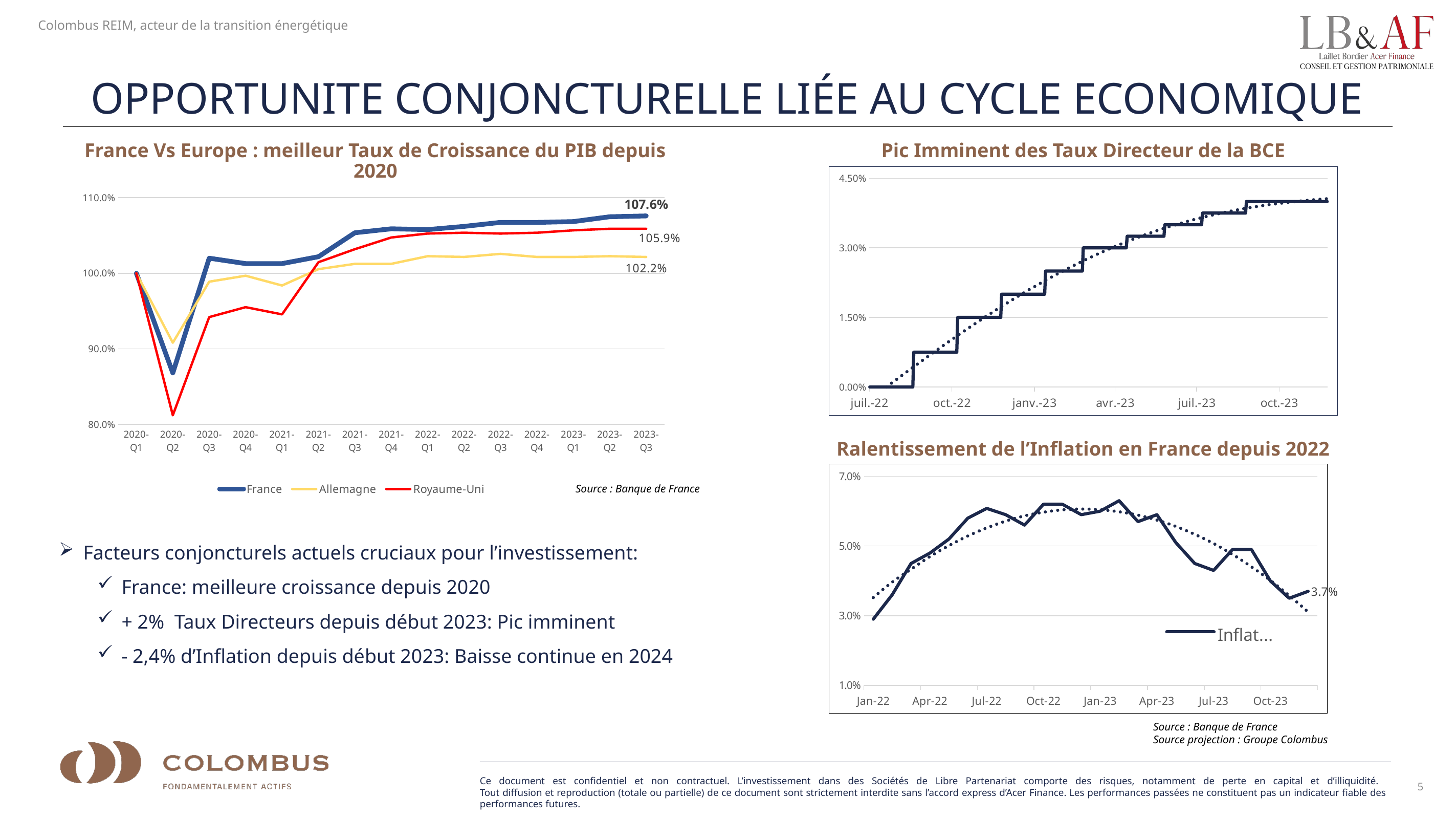
In the chart 'France Vs Europe : meilleur Taux de Croissance du PIB depuis 2020', which is larger at 2023-Q3: Royaume-Uni or Allemagne? Royaume-Uni How many quarters are shown on the x axis of the chart 'France Vs Europe : meilleur Taux de Croissance du PIB depuis 2020'? 15 How many series does the legend of the chart 'France Vs Europe : meilleur Taux de Croissance du PIB depuis 2020' list? 3 In the chart 'France Vs Europe : meilleur Taux de Croissance du PIB depuis 2020', is the value for Royaume-Uni at 2020-Q2 greater or less than 90.0%? less What kind of chart is 'Pic Imminent des Taux Directeur de la BCE'? line chart In the chart 'France Vs Europe : meilleur Taux de Croissance du PIB depuis 2020', what is the difference between the France and Allemagne values at 2023-Q3? 5.4 percentage points In the chart 'France Vs Europe : meilleur Taux de Croissance du PIB depuis 2020', what is the value for Allemagne at 2023-Q3? 102.2% In the chart 'France Vs Europe : meilleur Taux de Croissance du PIB depuis 2020', which series has the highest value at 2023-Q3? France In the chart 'France Vs Europe : meilleur Taux de Croissance du PIB depuis 2020', what is the value for France at 2023-Q3? 107.6% In the chart 'Pic Imminent des Taux Directeur de la BCE', do the values rise or fall from juil.-22 to oct.-23? rise In the chart 'Ralentissement de l'Inflation en France depuis 2022', what is the last labelled value of the inflation line? 3.7% In the chart 'France Vs Europe : meilleur Taux de Croissance du PIB depuis 2020', which series has the lowest value at 2020-Q2? Royaume-Uni